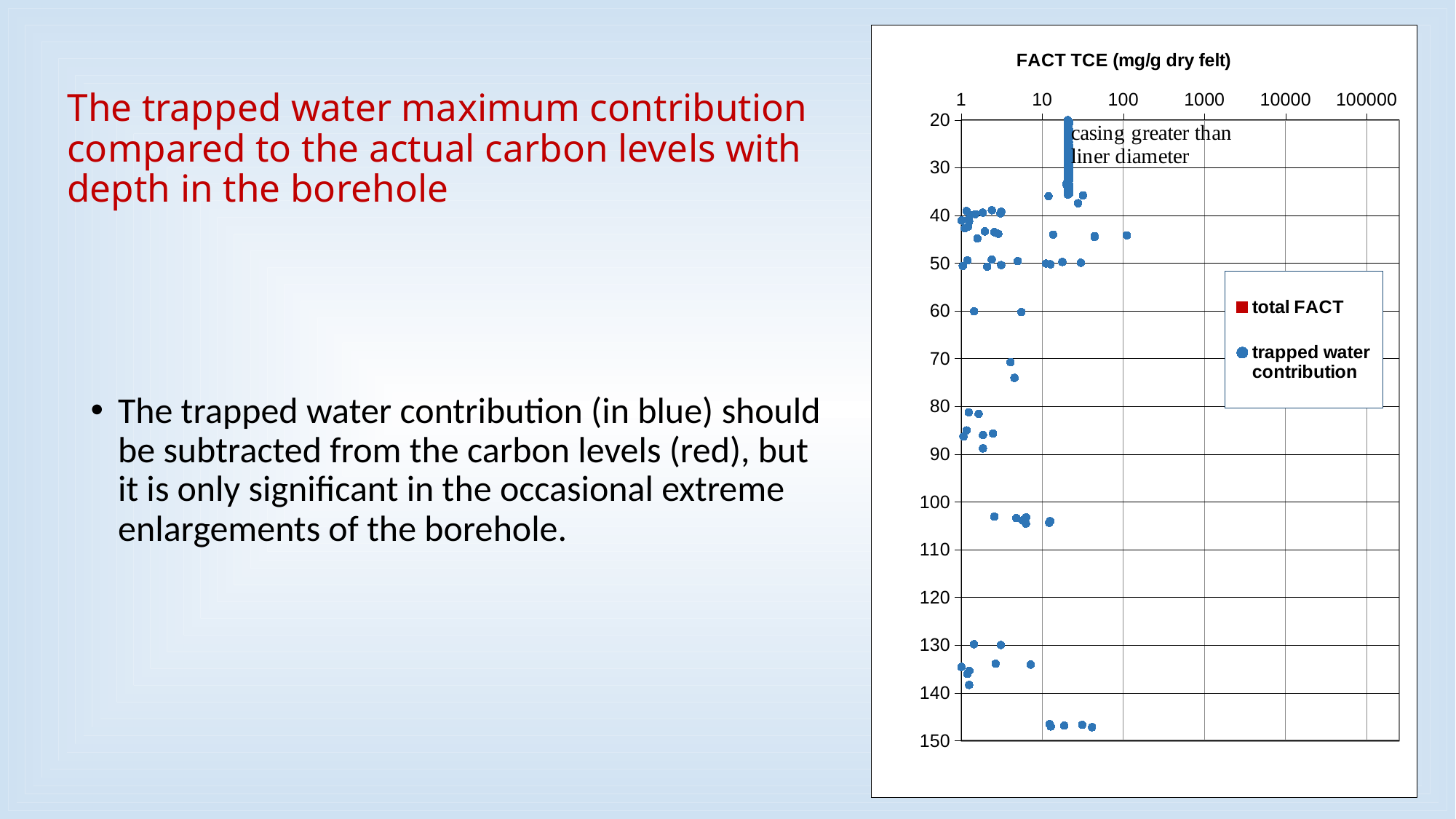
How many series does the chart legend list? 2 What kind of chart is shown on the slide? scatter chart What is the title of the chart? FACT TCE (mg/g dry felt) Is the trapped water contribution value of the point plotted at a depth of about 60 nearest the left edge greater or less than 10? less Is the trapped water contribution value of the rightmost point plotted at a depth of about 134 greater or less than 1? greater What is the largest depth value labelled on the y axis of the chart? 150 Which series is shown with blue circle markers in the legend? trapped water contribution What is the largest value labelled on the x axis of the chart? 100000 Is the trapped water contribution value of the rightmost point plotted at a depth of about 44 greater or less than 10? greater